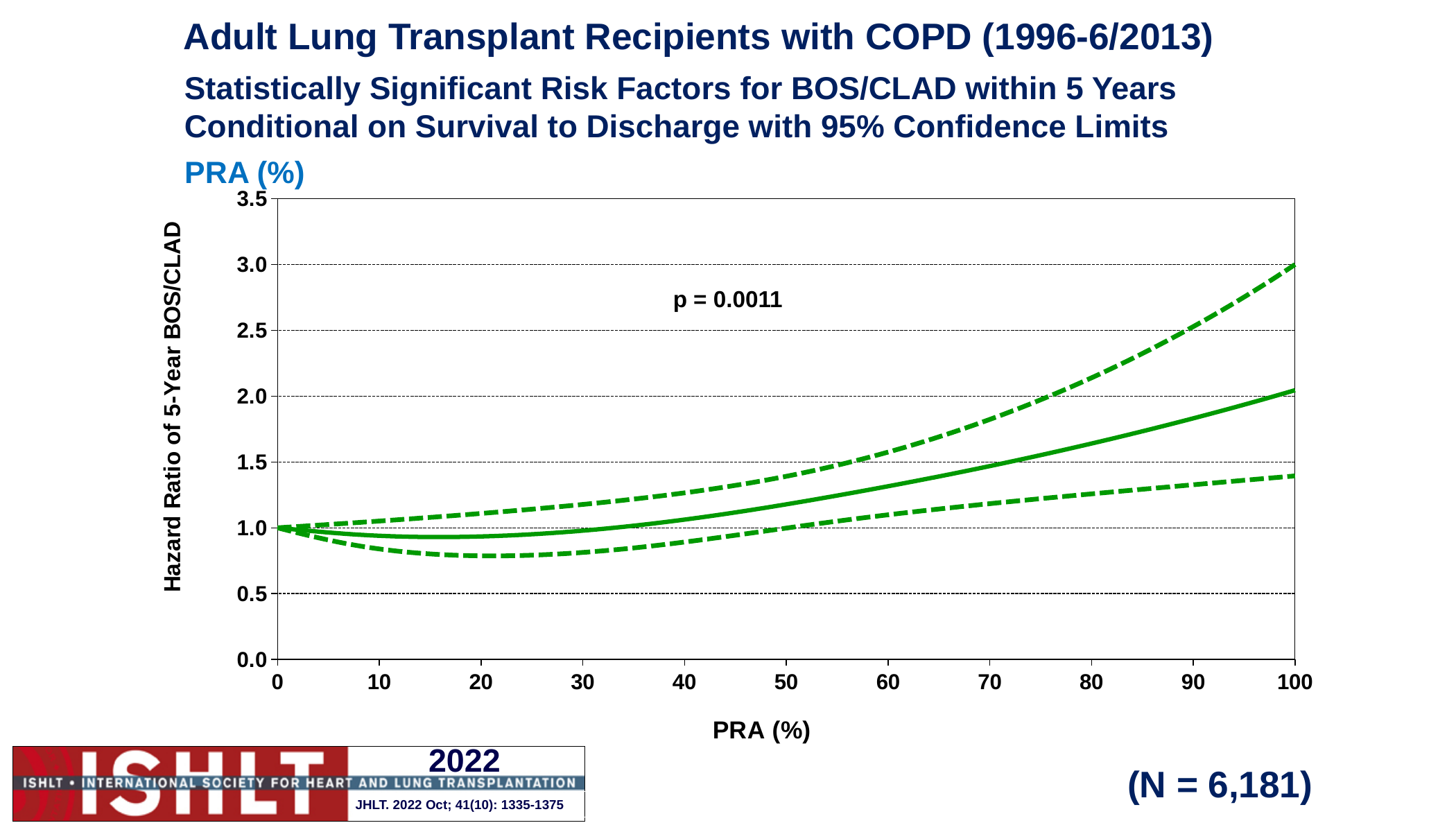
Is the lower dashed confidence limit at PRA 20% greater or less than 1.0? less How many lines are plotted on the chart? 3 What is the p-value printed on the chart? p = 0.0011 What value does the upper dashed confidence limit reach at PRA 100%? 3.0 Is the solid line's hazard ratio higher at PRA 100% or at PRA 20%? PRA 100% What is the sample size (N) shown on the slide? N = 6,181 Is the hazard ratio of the solid line at PRA 50% greater or less than 1.5? less Is the lower dashed confidence limit at PRA 100% greater or less than 1.0? greater What is the hazard ratio of the solid line at PRA 0%? 1.0 Does the solid hazard ratio line rise or fall between PRA 50% and PRA 100%? rise What kind of chart is shown on the slide? line chart